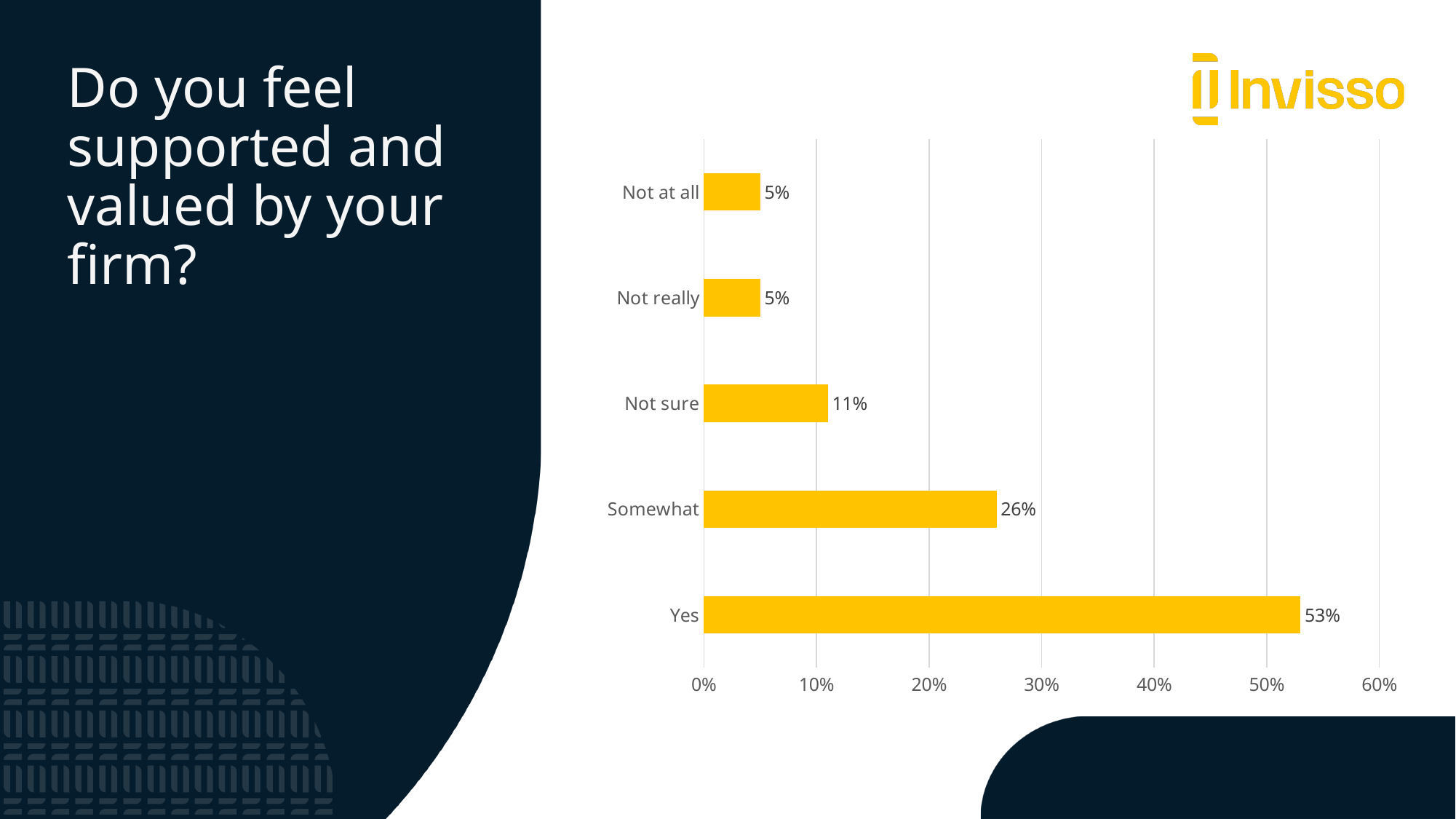
Which is larger, the value for "Not sure" or the value for "Somewhat"? Somewhat Which response category has the highest value? Yes What percentage of respondents answered "Not really"? 5% What is the difference between the "Somewhat" and "Not sure" values? 15% Is the value for "Yes" greater or less than 50%? greater What question does the chart on the slide answer? Do you feel supported and valued by your firm? What kind of chart is shown on the slide? Bar chart What percentage of respondents answered "Yes"? 53% How many response categories are shown in the chart? 5 What percentage of respondents answered "Somewhat"? 26% What percentage of respondents answered "Not sure"? 11% What is the difference between the "Yes" and "Somewhat" values? 27%